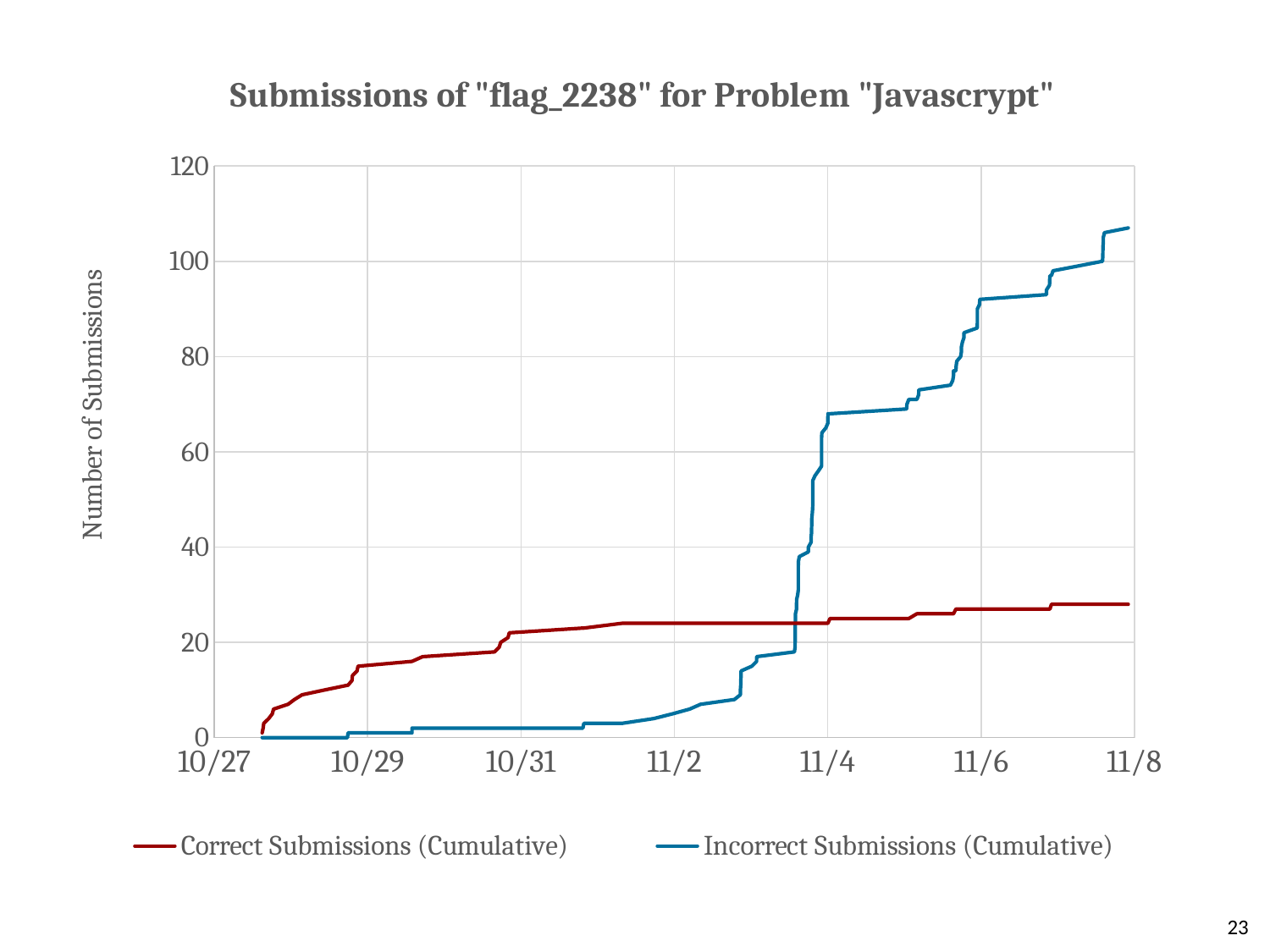
Is the value for Incorrect Submissions (Cumulative) at 11/2 greater or less than 20? less How many series does the legend list? 2 Is the value for Incorrect Submissions (Cumulative) at 11/6 greater or less than 80? greater How many date labels are shown on the x axis? 7 Do the Incorrect Submissions (Cumulative) values rise or fall along the x axis? rise What is the label on the vertical axis? Number of Submissions Is the value for Incorrect Submissions (Cumulative) at 11/8 greater or less than 100? greater What kind of chart is shown on the slide? line chart At 10/31, which series has the larger value: Correct Submissions (Cumulative) or Incorrect Submissions (Cumulative)? Correct Submissions (Cumulative) At 11/8, which series has the larger value: Correct Submissions (Cumulative) or Incorrect Submissions (Cumulative)? Incorrect Submissions (Cumulative) What is the title of the chart? Submissions of "flag_2238" for Problem "Javascrypt"